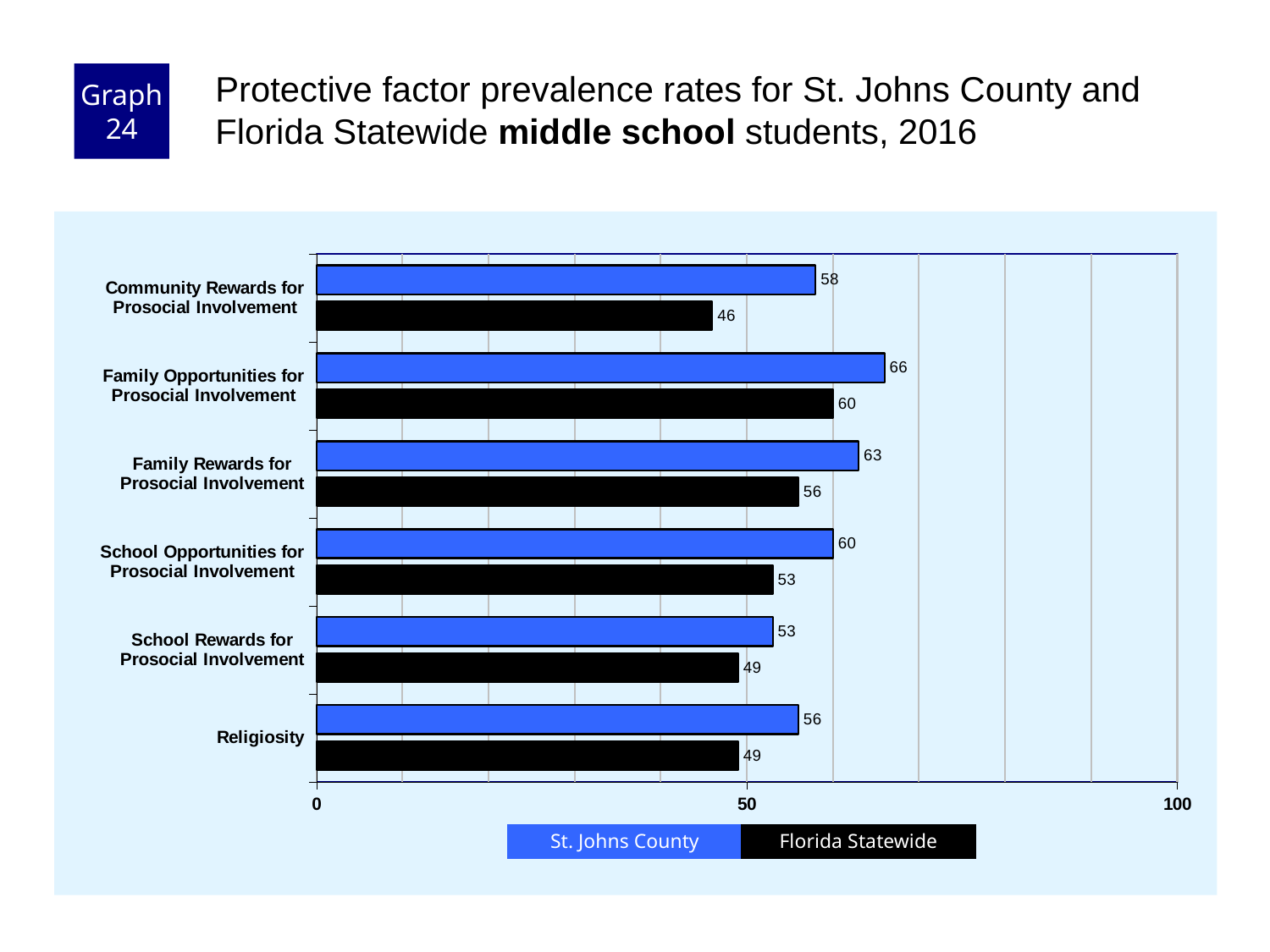
How many categories are shown on the chart? 6 What is the St. Johns County value for Family Opportunities for Prosocial Involvement? 66 What is the Florida Statewide value for Religiosity? 49 What is the difference between the St. Johns County and Florida Statewide values for Community Rewards for Prosocial Involvement? 12 Is the Florida Statewide value for Family Rewards for Prosocial Involvement greater or less than 50? greater What is the Florida Statewide value for Community Rewards for Prosocial Involvement? 46 Which category has the highest St. Johns County value? Family Opportunities for Prosocial Involvement Which colour represents Florida Statewide in the chart? Black What kind of chart is shown on the slide? Bar chart How many series does the legend list? 2 Which category has the lowest Florida Statewide value? Community Rewards for Prosocial Involvement Which is larger for School Opportunities for Prosocial Involvement: the St. Johns County value or the Florida Statewide value? St. Johns County